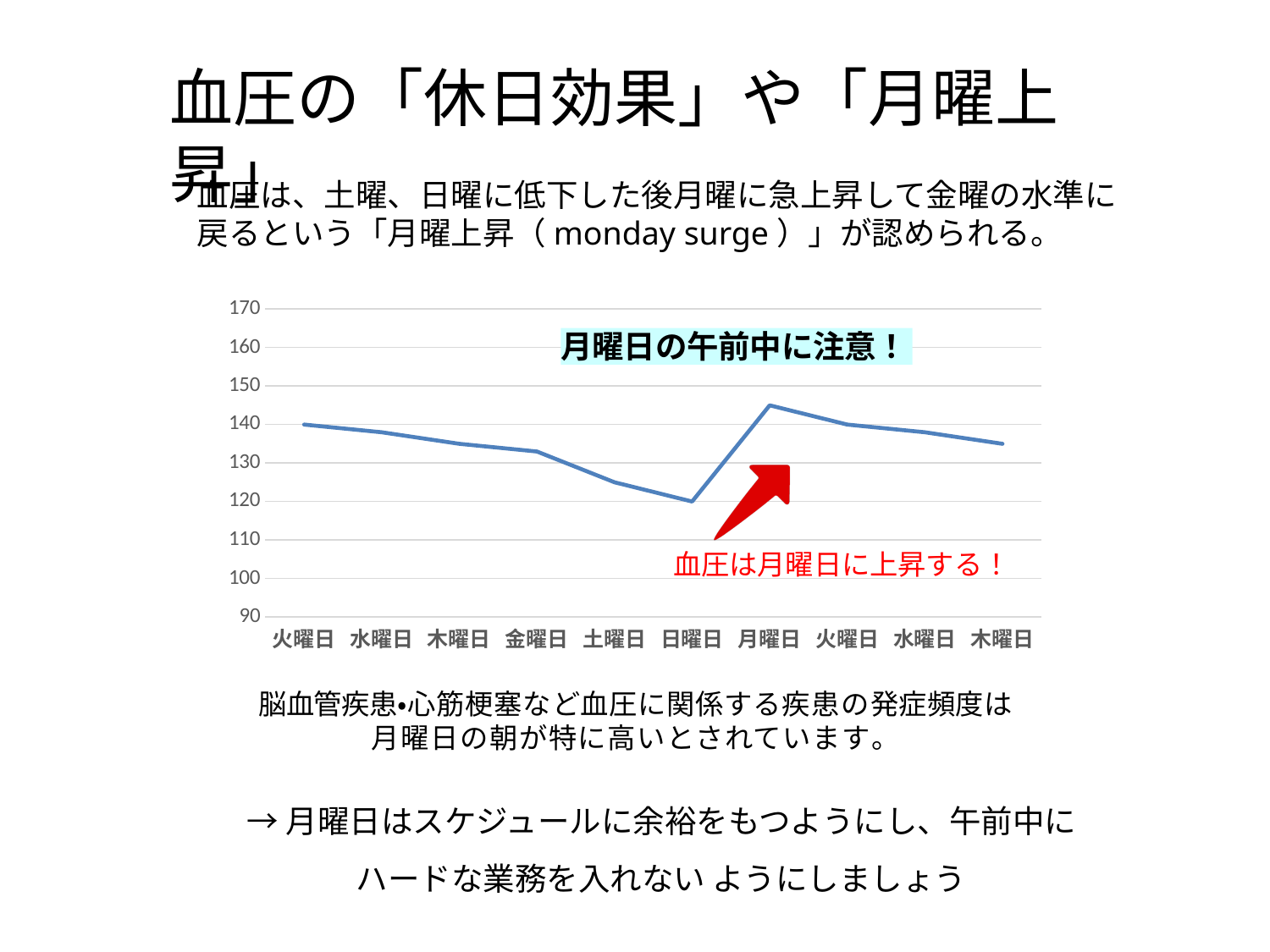
What kind of chart is shown on the slide? line chart How many days (data points) are plotted along the x axis? 10 On which day does the line reach its highest value? 月曜日 Is the value for 土曜日 greater or less than 130? less Is the value for 金曜日 greater or less than 130? greater Does the line rise or fall from 金曜日 to 日曜日? fall What does the red text next to the red arrow in the chart say? 血圧は月曜日に上昇する！ Which has the larger value, 月曜日 or 土曜日? 月曜日 What does the highlighted text above the line in the chart say? 月曜日の午前中に注意！ Is the value for 日曜日 greater or less than 130? less On which day does the line reach its lowest value? 日曜日